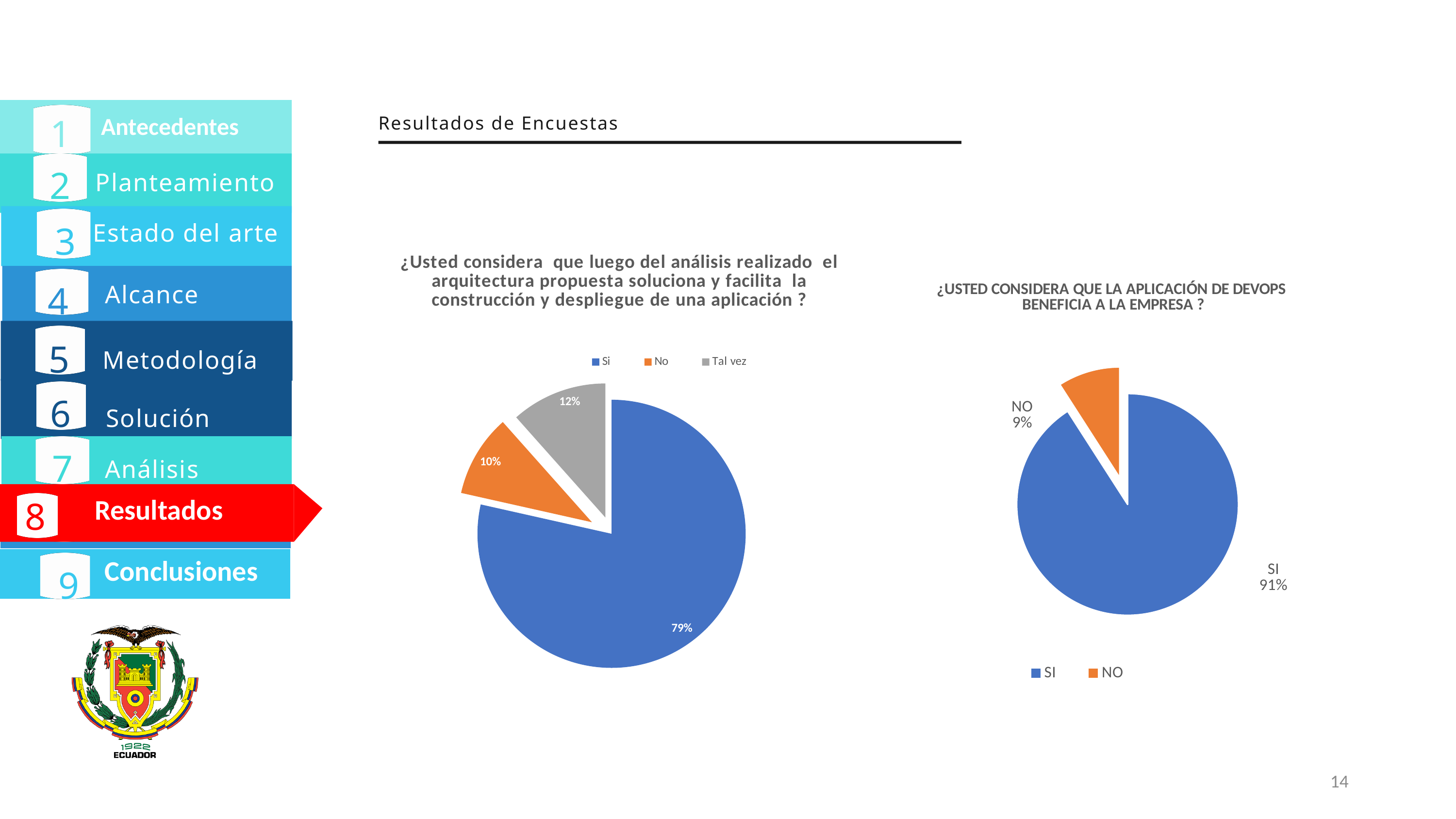
In the left pie chart, which response has the largest share? Si In the left pie chart, how many response categories are shown? 3 In the left pie chart, what percentage of respondents answered 'Tal vez'? 12% In the right pie chart (¿USTED CONSIDERA QUE LA APLICACIÓN DE DEVOPS BENEFICIA A LA EMPRESA?), what percentage answered 'NO'? 9% In the left pie chart, which response has the smallest share? No In the left pie chart, what percentage of respondents answered 'No'? 10% What type of chart is used on the right side of the slide? Pie chart In the left pie chart, what percentage of respondents answered 'Si'? 79% In the left pie chart, what is the difference between the 'Si' share and the 'Tal vez' share? 67% In the right pie chart, what colour is the 'NO' slice? Orange In the right pie chart, how many entries does the legend list? 2 In the right pie chart (¿USTED CONSIDERA QUE LA APLICACIÓN DE DEVOPS BENEFICIA A LA EMPRESA?), what percentage answered 'SI'? 91%